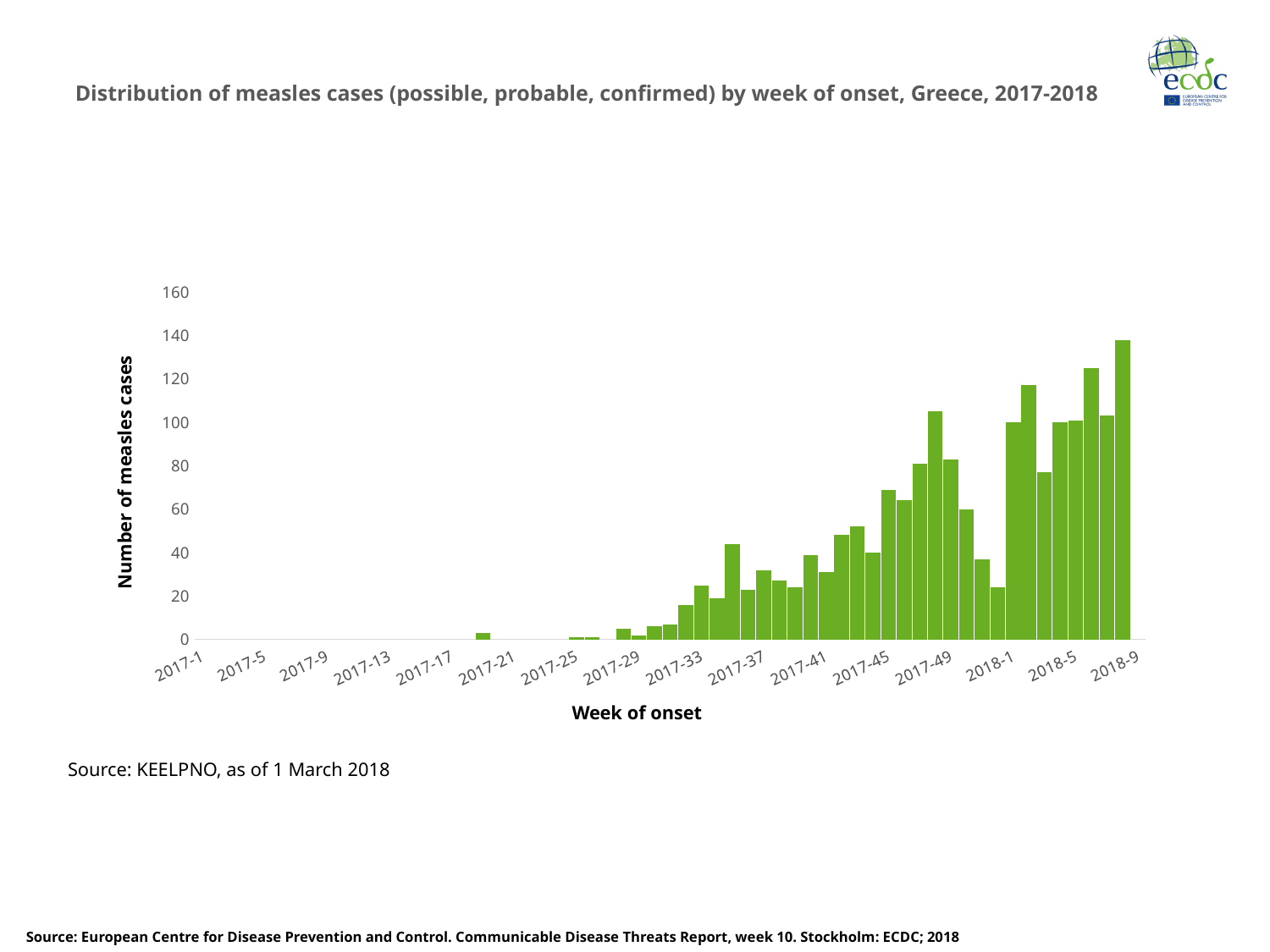
What is the title of the vertical axis? Number of measles cases Is the number of measles cases for week 2017-33 greater or less than 40? less What kind of chart is shown on the slide? bar chart Overall, do the number of measles cases rise or fall from 2017-1 to 2018-9? rise What is the title of the horizontal axis? Week of onset Is the number of measles cases for week 2017-37 greater or less than 60? less Is the number of measles cases for week 2017-29 greater or less than 20? less Which week has more measles cases, 2017-21 or 2017-49? 2017-49 Which week of onset has the highest number of measles cases? 2018-8